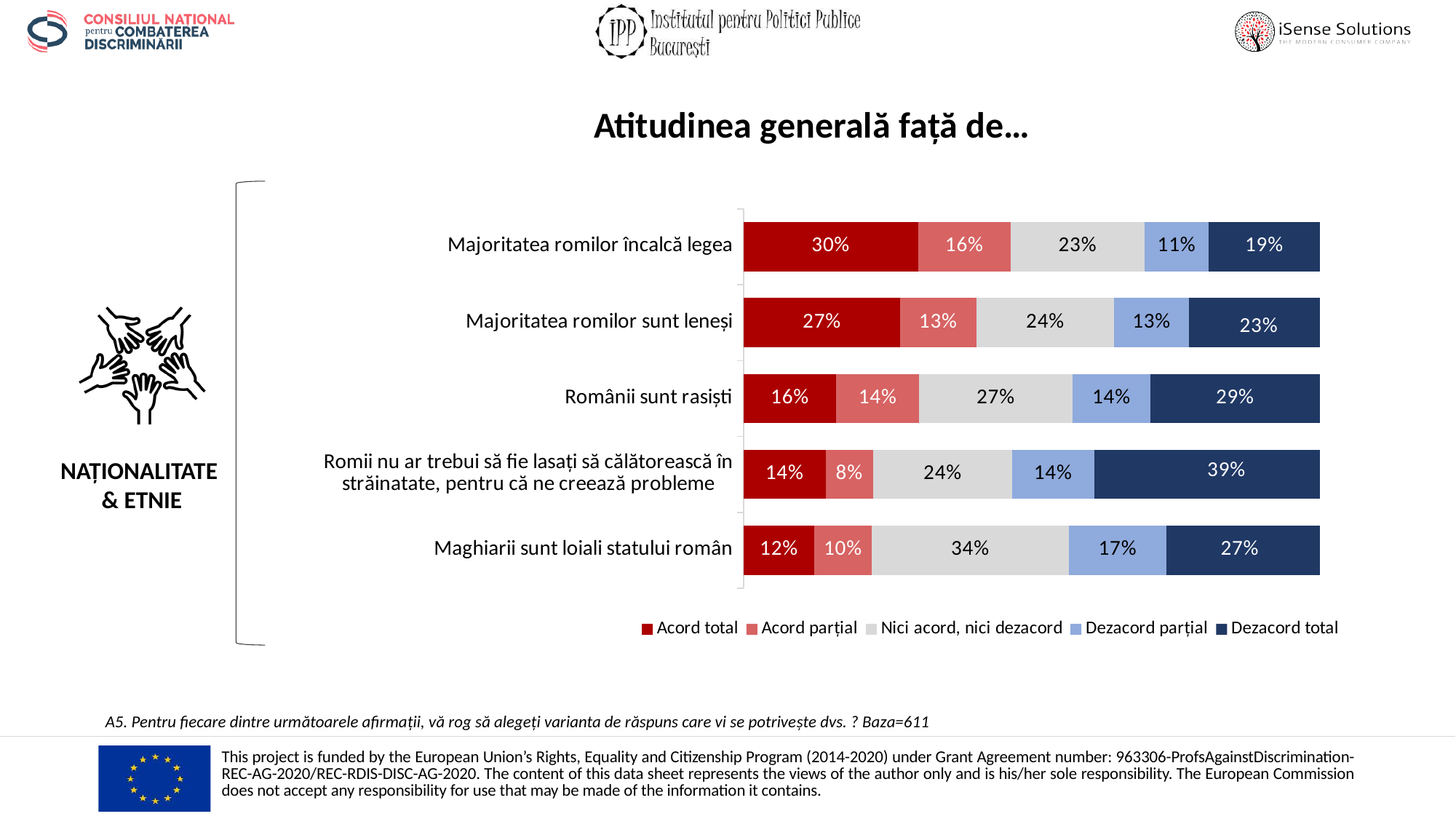
What is the "Dezacord parțial" value for "Maghiarii sunt loiali statului român"? 17% What is the "Nici acord, nici dezacord" value for "Maghiarii sunt loiali statului român"? 34% Which is larger: the "Acord total" share for "Majoritatea romilor sunt leneși" or for "Românii sunt rasiști"? Majoritatea romilor sunt leneși What percentage of respondents chose "Acord total" for "Majoritatea romilor încalcă legea"? 30% What is the "Dezacord total" value for "Romii nu ar trebui să fie lasați să călătorească în străinatate, pentru că ne creează probleme"? 39% Which statement has the lowest "Acord parțial" share? Romii nu ar trebui să fie lasați să călătorească în străinatate, pentru că ne creează probleme How many series does the legend list? 5 What type of chart is shown on the slide? Stacked bar chart Which legend entry is shown in dark blue? Dezacord total How many statements are shown in the chart? 5 Which statement has the highest "Acord total" share? Majoritatea romilor încalcă legea What is the difference between the "Dezacord total" values for "Românii sunt rasiști" and "Majoritatea romilor încalcă legea"? 10%